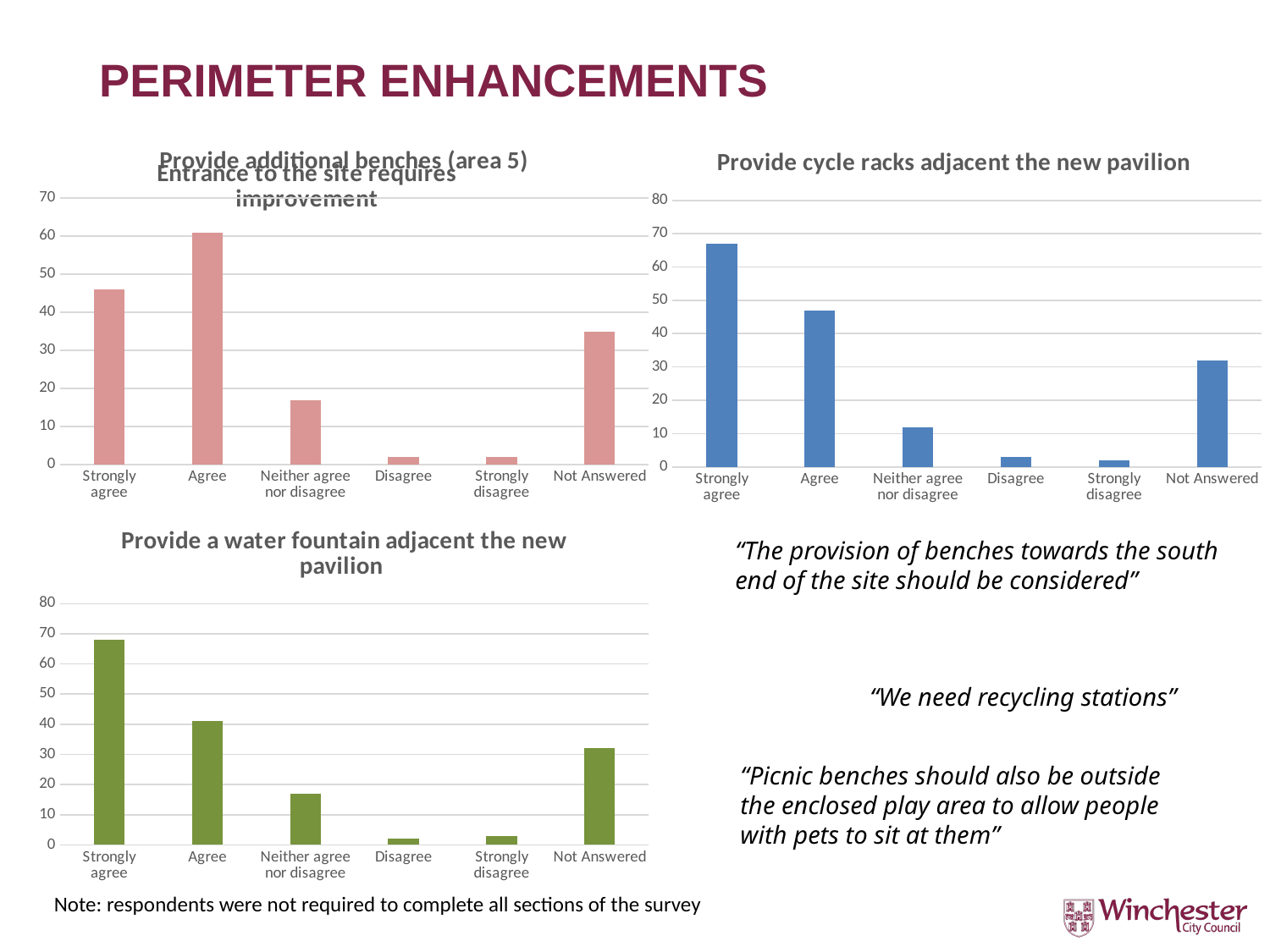
In the chart titled 'Provide cycle racks adjacent the new pavilion', is the value for Neither agree nor disagree greater or less than 20? less In the chart titled 'Provide a water fountain adjacent the new pavilion', which category has the highest value? Strongly agree In the top-left chart, is the value for Not Answered greater or less than 30? greater In the top-left chart, which category has the highest value? Agree How many categories are shown on the x axis of the chart titled 'Provide a water fountain adjacent the new pavilion'? 6 In the chart titled 'Provide a water fountain adjacent the new pavilion', which is larger, the value for Neither agree nor disagree or the value for Not Answered? Not Answered In the chart titled 'Provide a water fountain adjacent the new pavilion', is the value for Agree greater or less than 50? less In the chart titled 'Provide cycle racks adjacent the new pavilion', which is larger, the value for Agree or the value for Not Answered? Agree What kind of chart is the chart titled 'Provide cycle racks adjacent the new pavilion'? bar chart In the chart titled 'Provide cycle racks adjacent the new pavilion', which category has the highest value? Strongly agree In the top-left chart, which is larger, the value for Strongly agree or the value for Agree? Agree